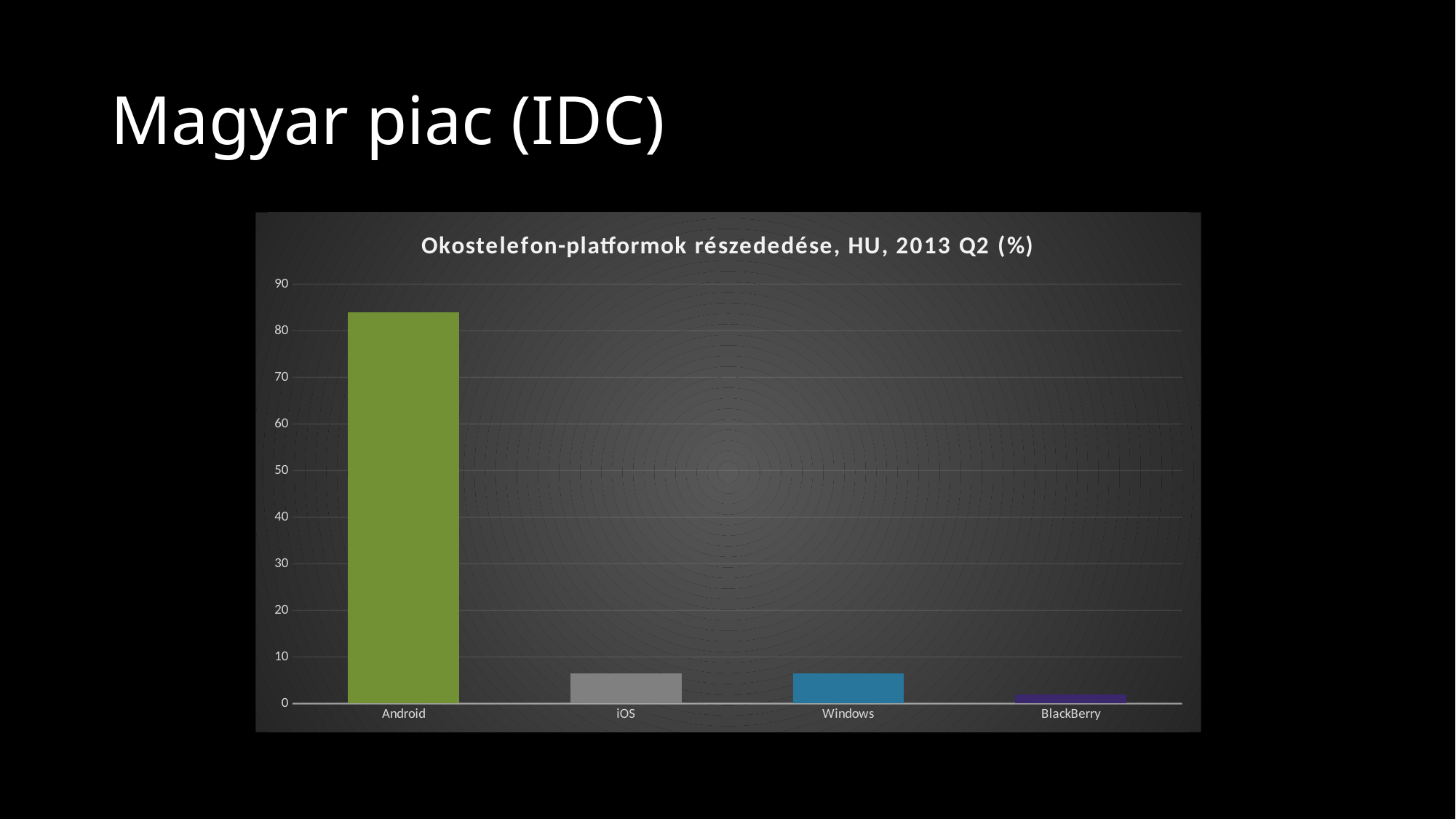
Is the value for BlackBerry greater or less than 10? less Which platform has the lowest value in the chart? BlackBerry What is the title of the chart? Okostelefon-platformok részededése, HU, 2013 Q2 (%) Is the value for Android greater or less than 90? less How many platforms (categories) are shown on the x axis of the chart? 4 What kind of chart is shown on the slide? bar chart Is the value for iOS greater or less than 10? less Which is larger, the value for Windows or the value for BlackBerry? Windows Which platform has the highest value in the chart? Android Which is larger, the value for Android or the value for iOS? Android